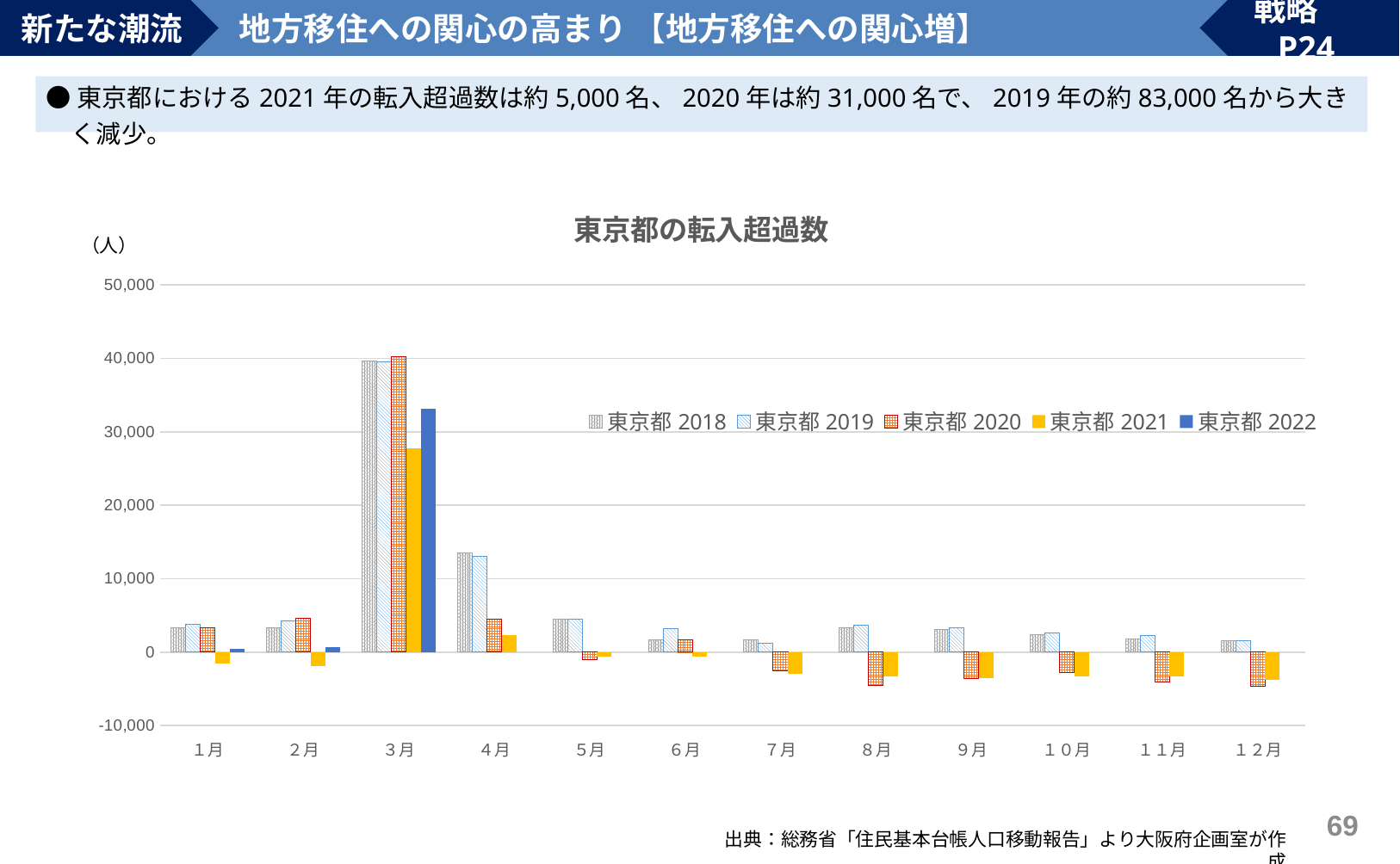
What kind of chart is shown on the slide? bar chart How many series does the legend list? 5 In 3月, which is larger: the value for 東京都 2021 or 東京都 2022? 東京都 2022 In which month are the bars highest across all series? 3月 Is the value for 東京都 2021 in 3月 greater or less than 30,000? less Is the value for 東京都 2021 in 4月 greater or less than 10,000? less Which series in 3月 has the lowest value? 東京都 2021 Is the value for 東京都 2018 in 4月 greater or less than 10,000? greater In 8月, which is larger: the value for 東京都 2019 or 東京都 2020? 東京都 2019 What is the title of the chart? 東京都の転入超過数 How many months (categories) are shown on the x axis? 12